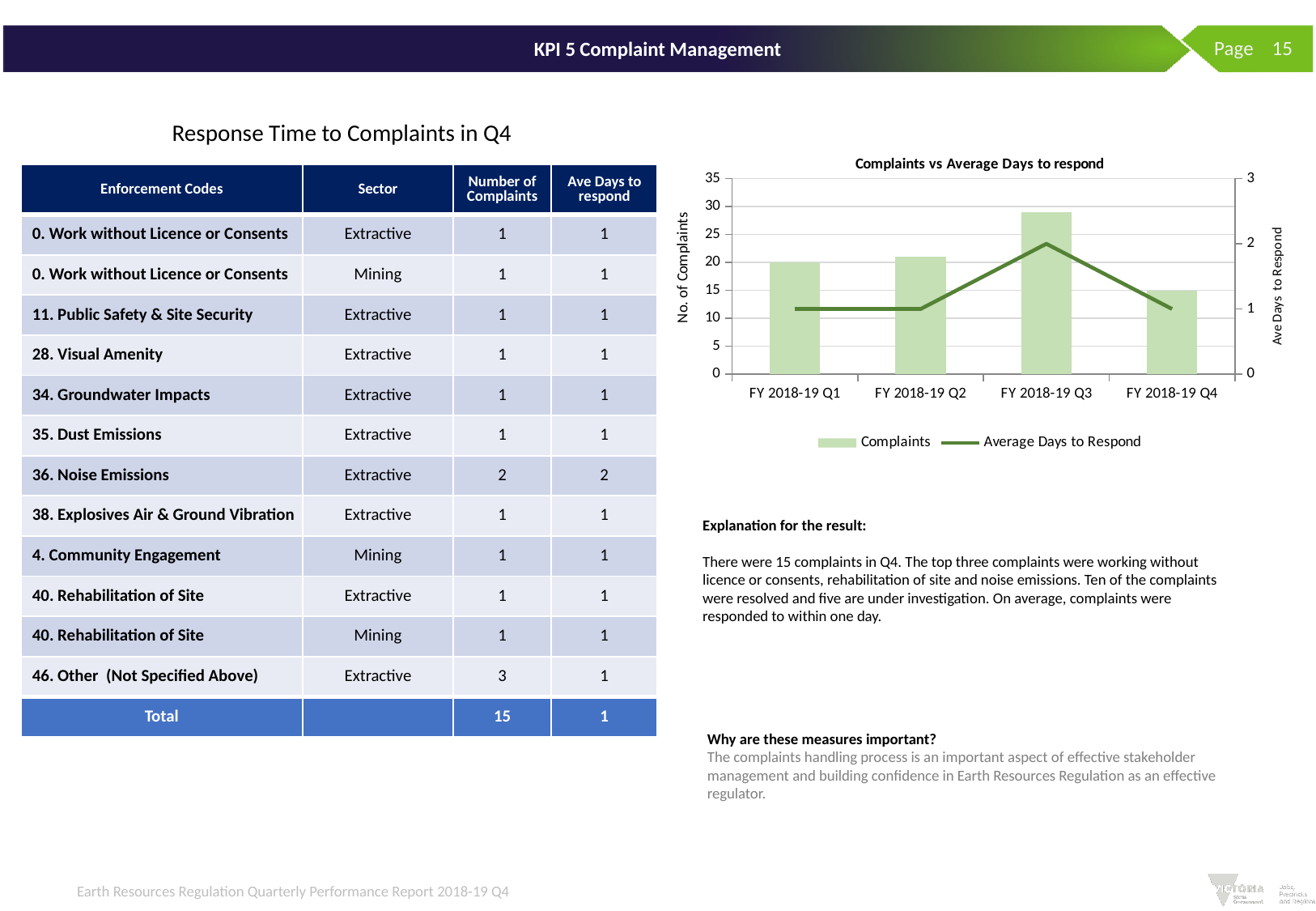
Which quarter has more complaints, FY 2018-19 Q1 or FY 2018-19 Q3? FY 2018-19 Q3 Which quarter has the highest number of complaints in the chart? FY 2018-19 Q3 Is the number of complaints for FY 2018-19 Q2 greater or less than 25? less What kind of chart is shown on the slide? A bar chart with a line Is the number of complaints for FY 2018-19 Q3 greater or less than 25? greater What is the average days to respond for FY 2018-19 Q3 in the chart? 2 How many series does the chart legend list? 2 How many quarters are plotted on the x axis of the chart? 4 Does the average days to respond rise or fall from FY 2018-19 Q3 to FY 2018-19 Q4? Fall What is the title of the chart? Complaints vs Average Days to respond How many complaints are shown for FY 2018-19 Q4 in the chart? 15 Which quarter has the lowest number of complaints in the chart? FY 2018-19 Q4